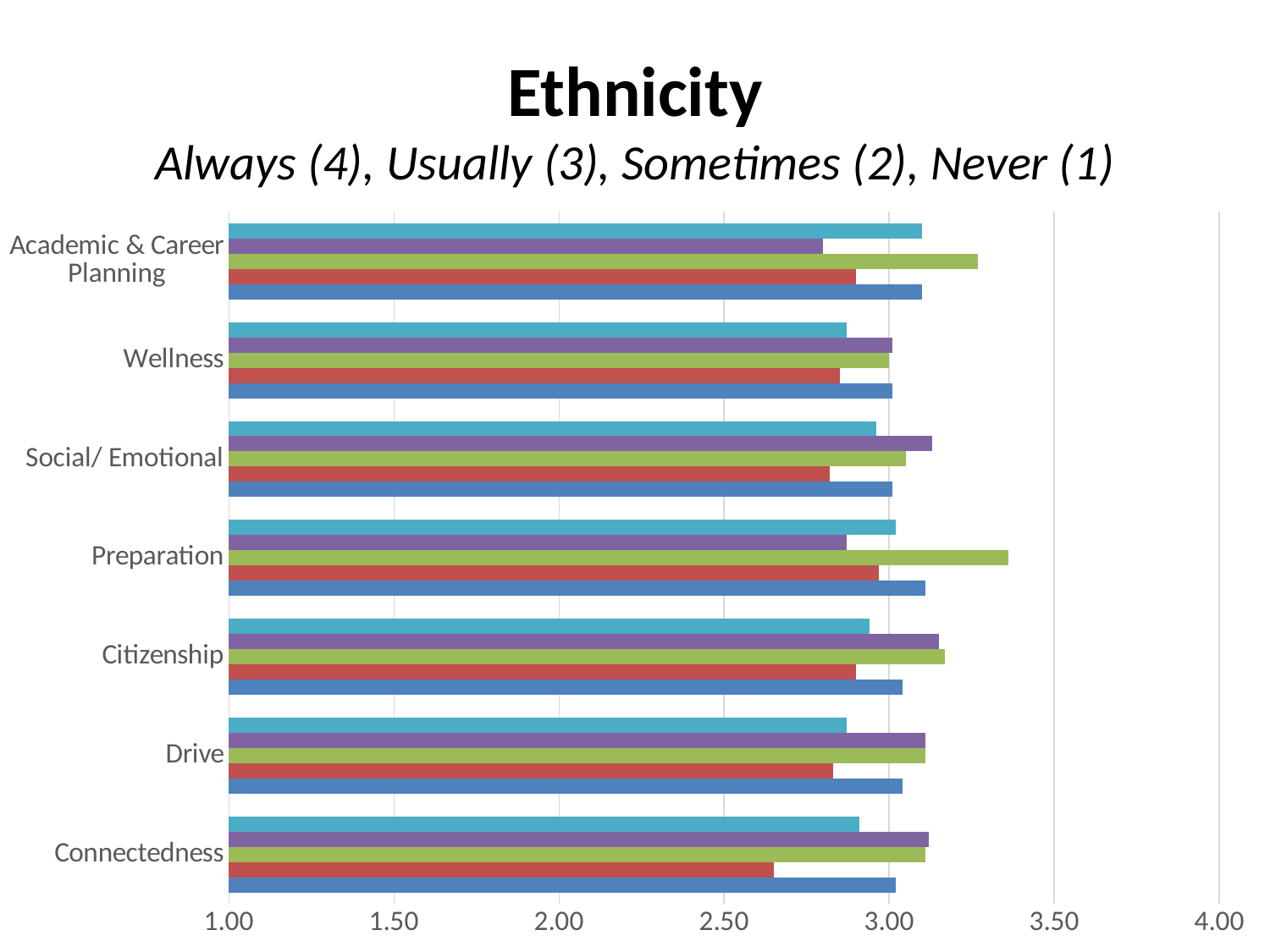
Which category contains the shortest bar in the chart? Connectedness Is the red bar for Drive greater or less than 3.00? less How many bars are plotted for each category in the chart? 5 Which category contains the longest bar in the chart? Preparation Is the red bar for Connectedness greater or less than 3.00? less Is the green bar for Preparation greater or less than 3.00? greater What is the title of the chart? Ethnicity What is the highest value shown on the horizontal axis of the chart? 4.00 How many categories are listed on the vertical axis of the chart? 7 What type of chart is shown on the slide? bar chart For Preparation, which is larger: the green bar or the red bar? the green bar